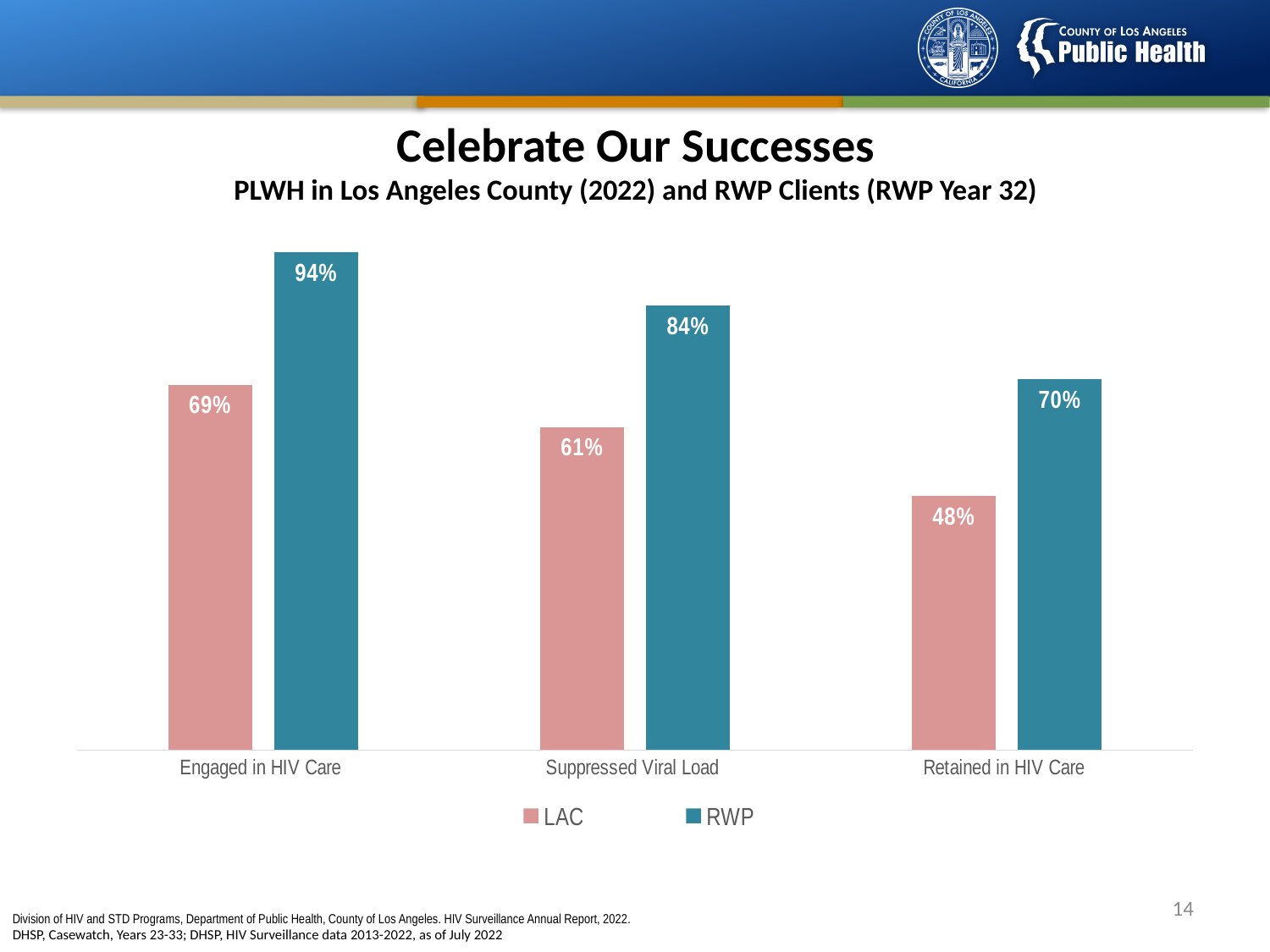
What is the RWP value for Engaged in HIV Care? 94% What is the difference between the RWP and LAC values for Engaged in HIV Care? 25% Which category has the highest RWP value? Engaged in HIV Care What is the LAC value for Retained in HIV Care? 48% What kind of chart is shown on the slide? Bar chart How many categories are shown on the x axis? 3 Which category has the lowest LAC value? Retained in HIV Care How many series does the legend list? 2 Which is larger for Retained in HIV Care, the LAC value or the RWP value? RWP What is the difference between the RWP and LAC values for Suppressed Viral Load? 23% What is the RWP value for Retained in HIV Care? 70% What is the LAC value for Suppressed Viral Load? 61%